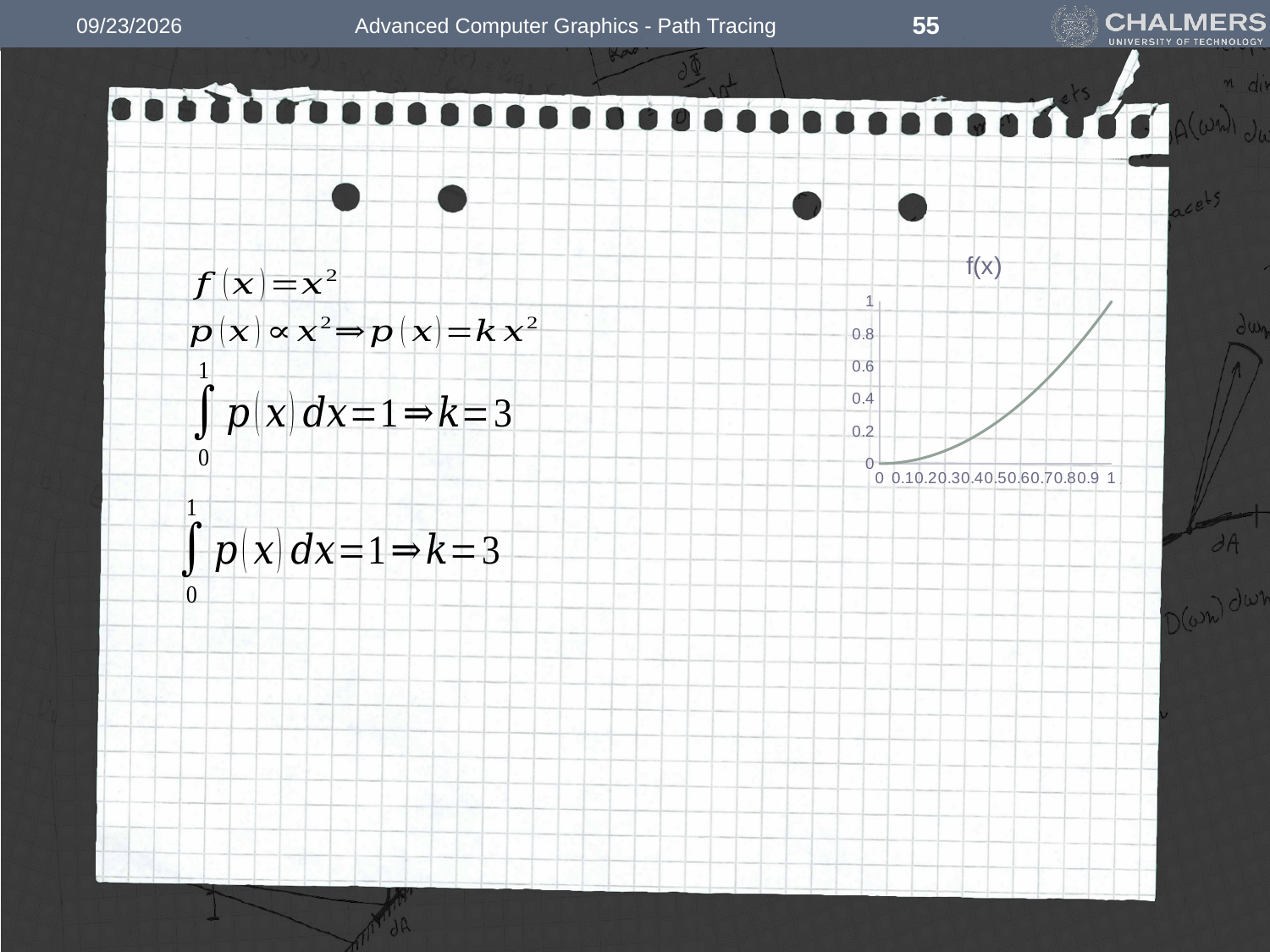
What is the title of the chart? f(x) What is the value of the curve at x = 1? 1 Does the plotted curve rise or fall as x increases from 0 to 1? rises At which x value does the curve reach its highest point? 1 Is the value of the curve at x = 0.5 greater or less than 0.4? less At which x value is the curve at its lowest point? 0 Is the value of the curve at x = 0.3 greater or less than 0.2? less What kind of chart is shown on the slide? line chart Which is larger, the value of the curve at x = 0.9 or at x = 0.5? x = 0.9 Is the value of the curve at x = 0.9 greater or less than 0.6? greater What is the value of the curve at x = 0? 0 How many tick labels are shown on the x axis? 11